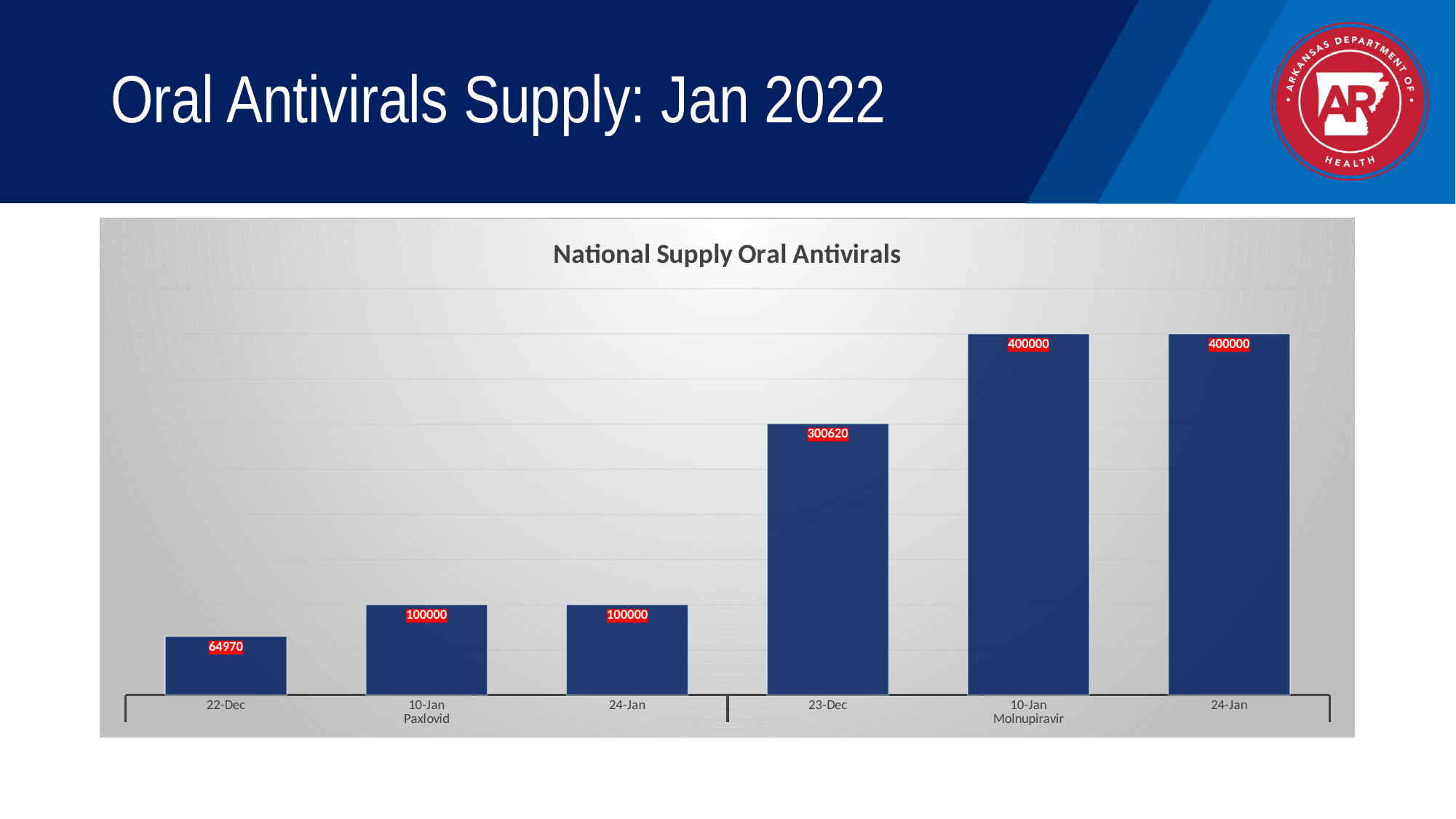
Do the Molnupiravir supply values rise or fall from 23-Dec to 24-Jan? Rise What is the national supply value for Paxlovid on 22-Dec? 64970 What is the national supply value for Molnupiravir on 24-Jan? 400000 What is the difference between the Molnupiravir supply on 23-Dec and the Paxlovid supply on 22-Dec? 235650 Which is larger: the Molnupiravir supply on 23-Dec or the Paxlovid supply on 24-Jan? Molnupiravir 23-Dec What is the national supply value for Molnupiravir on 23-Dec? 300620 What is the difference between the Molnupiravir supply on 10-Jan and the Paxlovid supply on 10-Jan? 300000 What kind of chart is shown on the slide? Bar chart Which bar has the lowest value in the chart? Paxlovid 22-Dec How many bars are plotted in the chart? 6 What is the national supply value for Paxlovid on 10-Jan? 100000 What is the title of the chart? National Supply Oral Antivirals